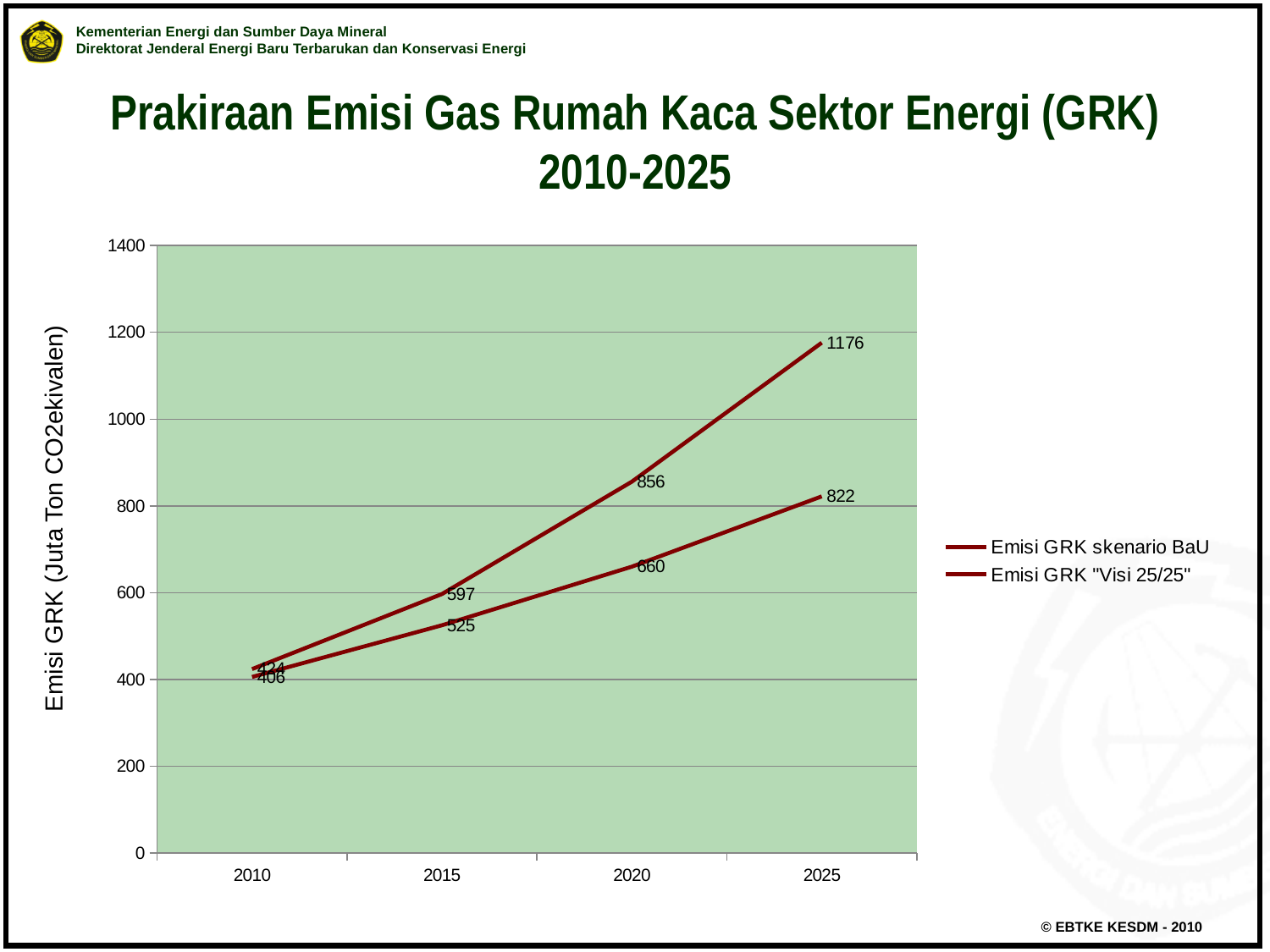
What is the value of the lower line in 2025? 822 What is the value of the upper line in 2020? 856 How many series does the legend list? 2 What is the difference between the two lines' values in 2025? 354 What is the title of the y axis? Emisi GRK (Juta Ton CO2ekivalen) What kind of chart is shown on the slide? line chart Do the values of both lines rise or fall from 2010 to 2025? rise What is the value of the lower line in 2020? 660 How many years are plotted along the x axis? 4 What is the highest value labelled on the chart for 2025? 1176 What is the value of the upper line in 2015? 597 What is the difference between the two lines' values in 2020? 196